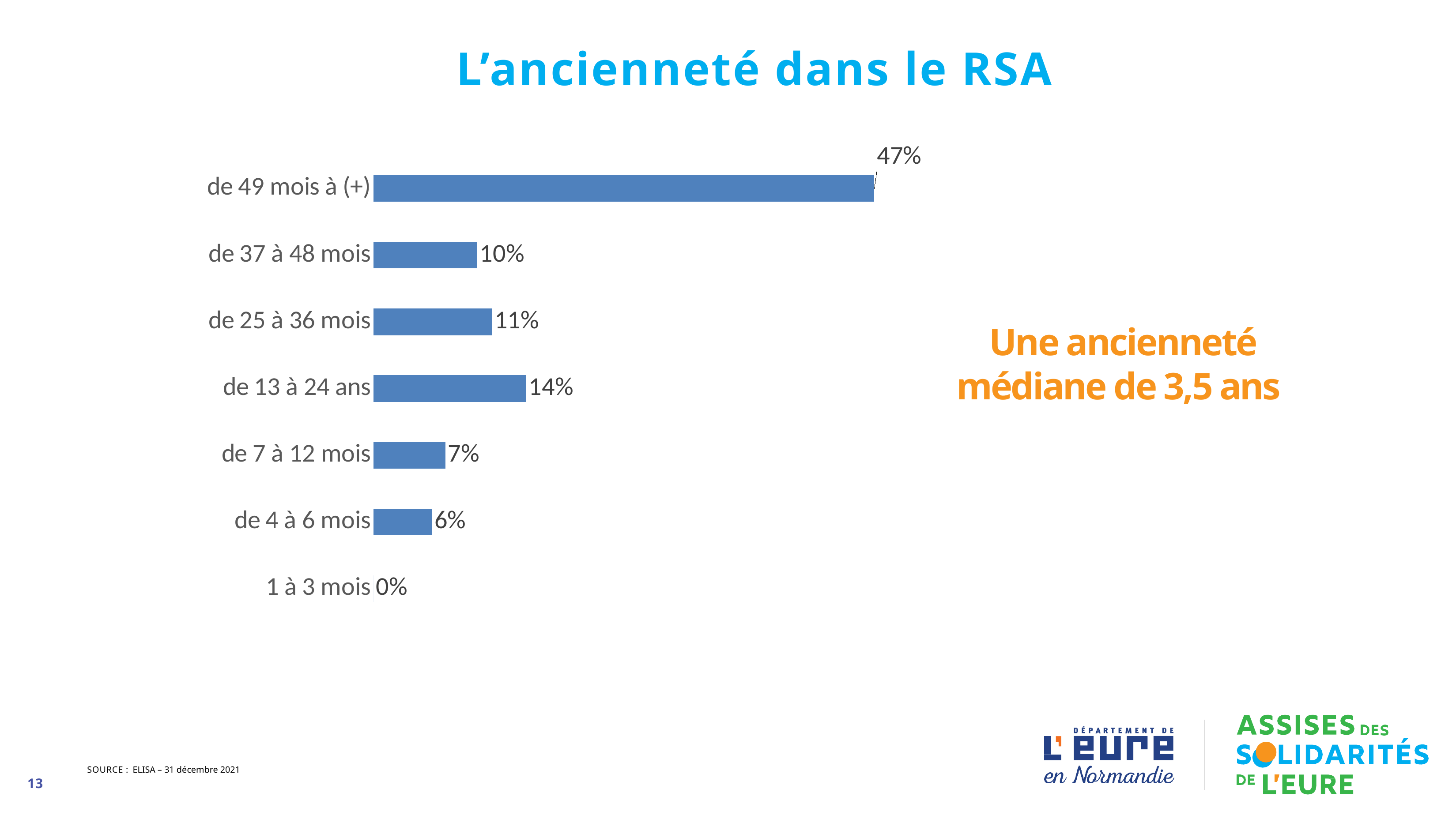
What is the value for 'de 49 mois à (+)'? 47% What is the value for 'de 4 à 6 mois'? 6% What is the difference between the values for 'de 49 mois à (+)' and 'de 37 à 48 mois'? 37% What is the value for 'de 13 à 24 ans'? 14% Which category has the highest value? de 49 mois à (+) What is the title of the slide containing the chart? L'ancienneté dans le RSA What is the difference between the values for 'de 13 à 24 ans' and 'de 7 à 12 mois'? 7% Which is larger, the value for 'de 25 à 36 mois' or 'de 37 à 48 mois'? de 25 à 36 mois What is the value for '1 à 3 mois'? 0% What kind of chart is shown on the slide? bar chart Which category has the lowest value? 1 à 3 mois How many categories are shown in the chart? 7